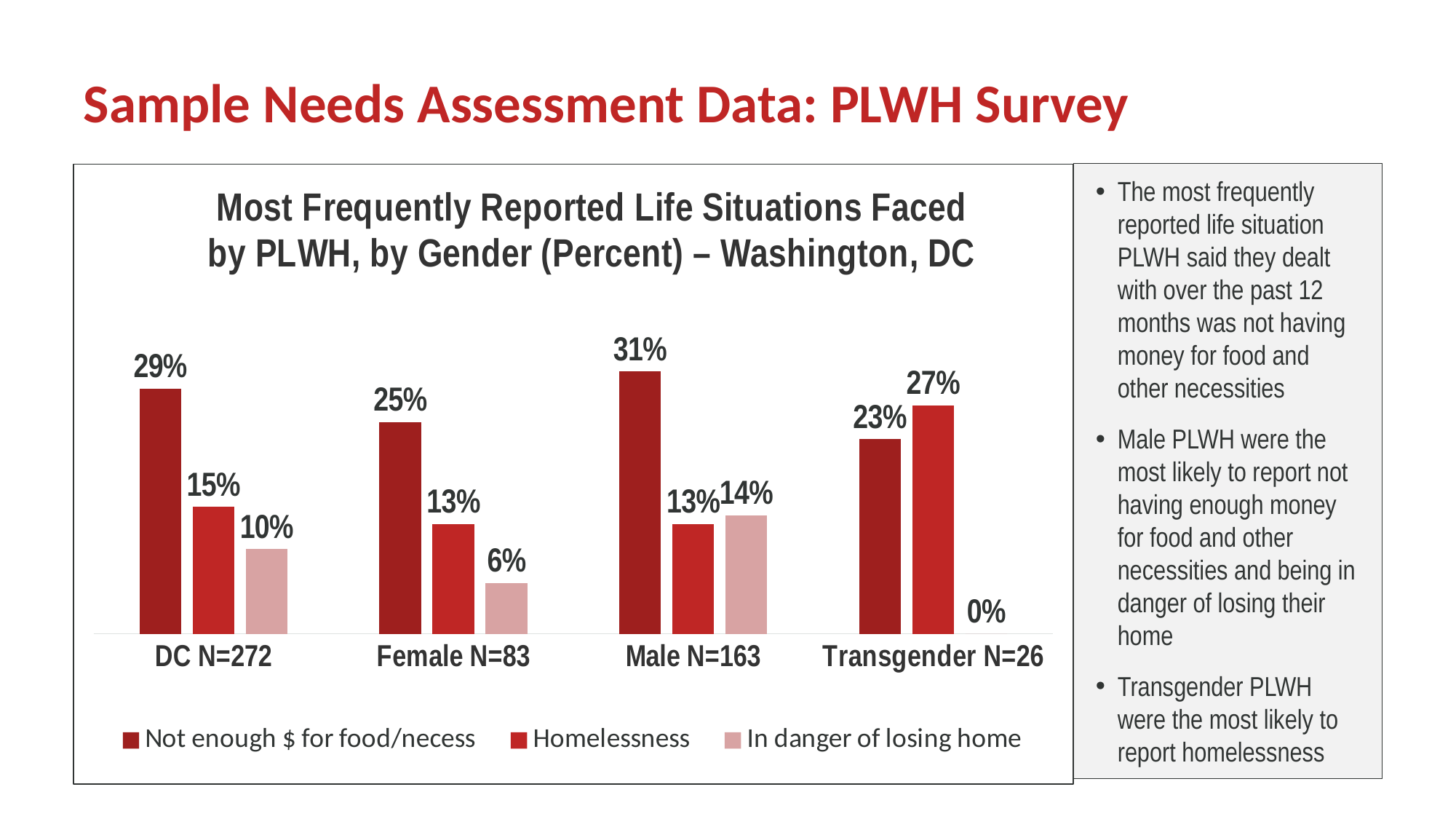
What is the value for 'In danger of losing home' for Transgender N=26? 0% What percentage of Female PLWH (N=83) reported being in danger of losing their home? 6% Which group has the lowest value for 'In danger of losing home'? Transgender N=26 What percentage of Male PLWH (N=163) reported not having enough money for food/necessities? 31% How many gender/population groups are shown on the x axis? 4 What is the title of the chart? Most Frequently Reported Life Situations Faced by PLWH, by Gender (Percent) – Washington, DC Which gender group has the highest value for 'Not enough $ for food/necess'? Male N=163 Which is larger for Transgender N=26: 'Not enough $ for food/necess' or 'Homelessness'? Homelessness What type of chart is shown on the slide? Bar chart What is the difference between the 'Not enough $ for food/necess' values for Male N=163 and Female N=83? 6% How many series does the legend list? 3 What percentage of Transgender PLWH (N=26) reported homelessness? 27%